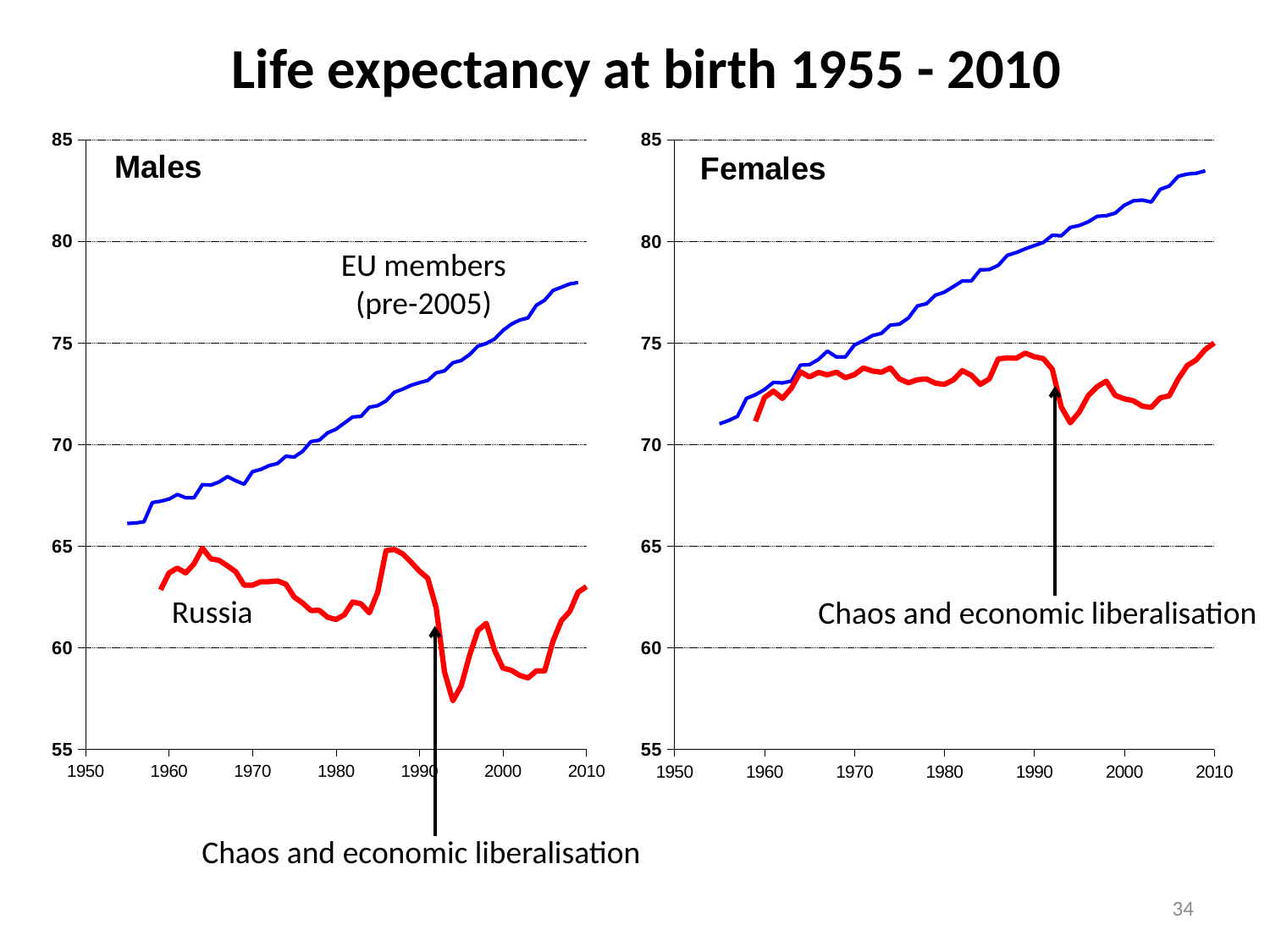
On the Females chart, is the value of the blue line in 2010 greater or less than 80? greater On the Females chart, which line is higher in 2010, the blue line or the red line? the blue line What kind of chart is the Males chart? line chart How many lines are plotted on the Males chart? 2 On the Females chart, is the value of the blue line in 1955 greater or less than 75? less On the Males chart, is the value for Russia in 1980 greater or less than 65? less On the Males chart, which two groups are labelled? EU members (pre-2005) and Russia What event do the arrows on both charts point to, according to the annotation? Chaos and economic liberalisation On the Males chart, which line is higher in 2000, EU members (pre-2005) or Russia? EU members (pre-2005) On the Males chart, does the EU members (pre-2005) line rise or fall from 1955 to 2010? rise